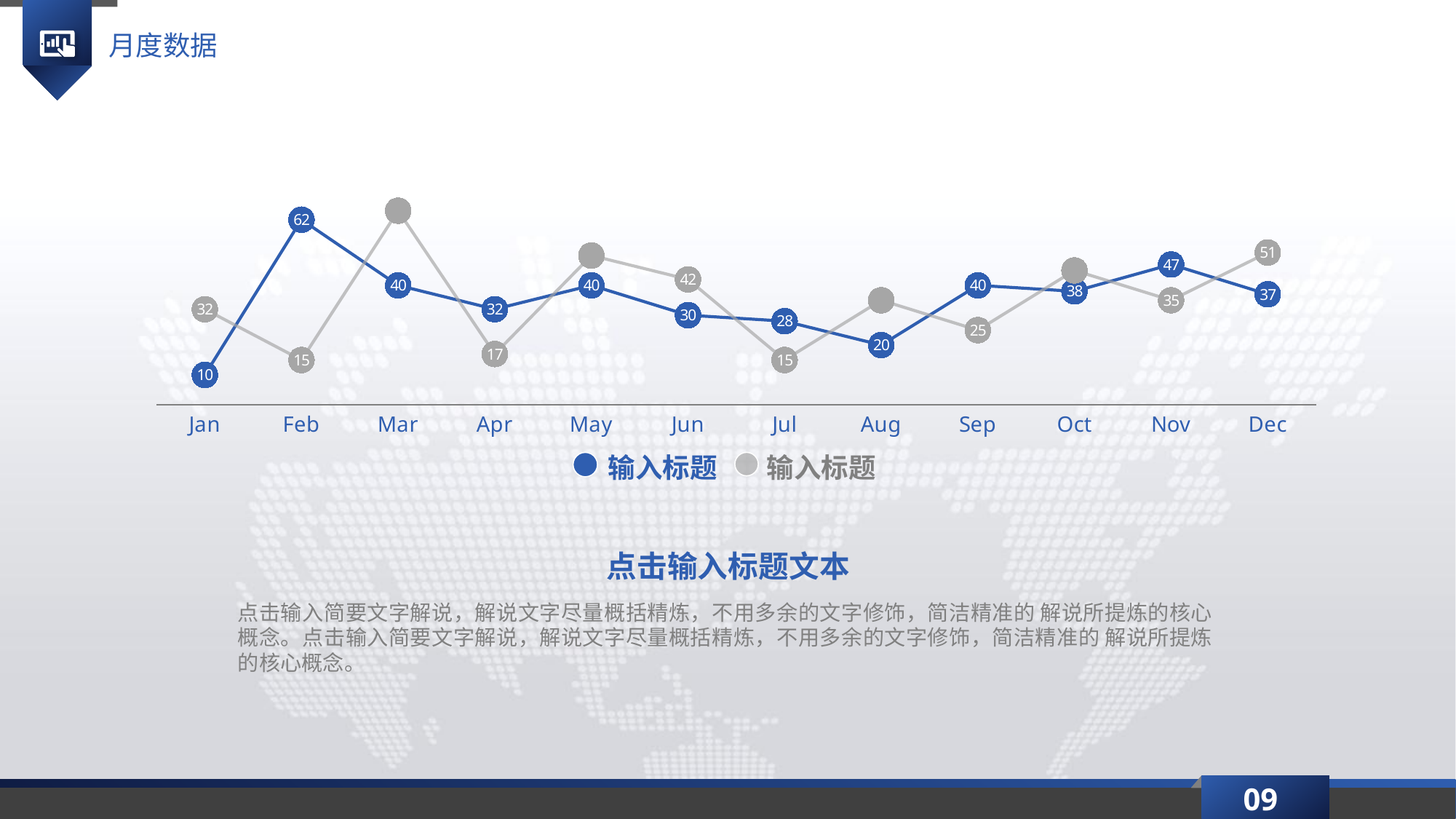
What is the value of the blue series in Aug? 20 How many months are plotted along the x axis? 12 In which month does the blue series have its lowest value? Jan What is the difference between the blue series values in Feb and Jan? 52 Does the blue series rise or fall from Jun to Aug? fall In which month does the grey series reach its highest point? Mar How many series does the legend list? 2 In Jun, which series has the larger value, blue or grey? grey In which month does the blue series reach its highest value? Feb What is the value of the blue series in Feb? 62 What type of chart is shown on the slide? line chart What is the value of the grey series in Dec? 51